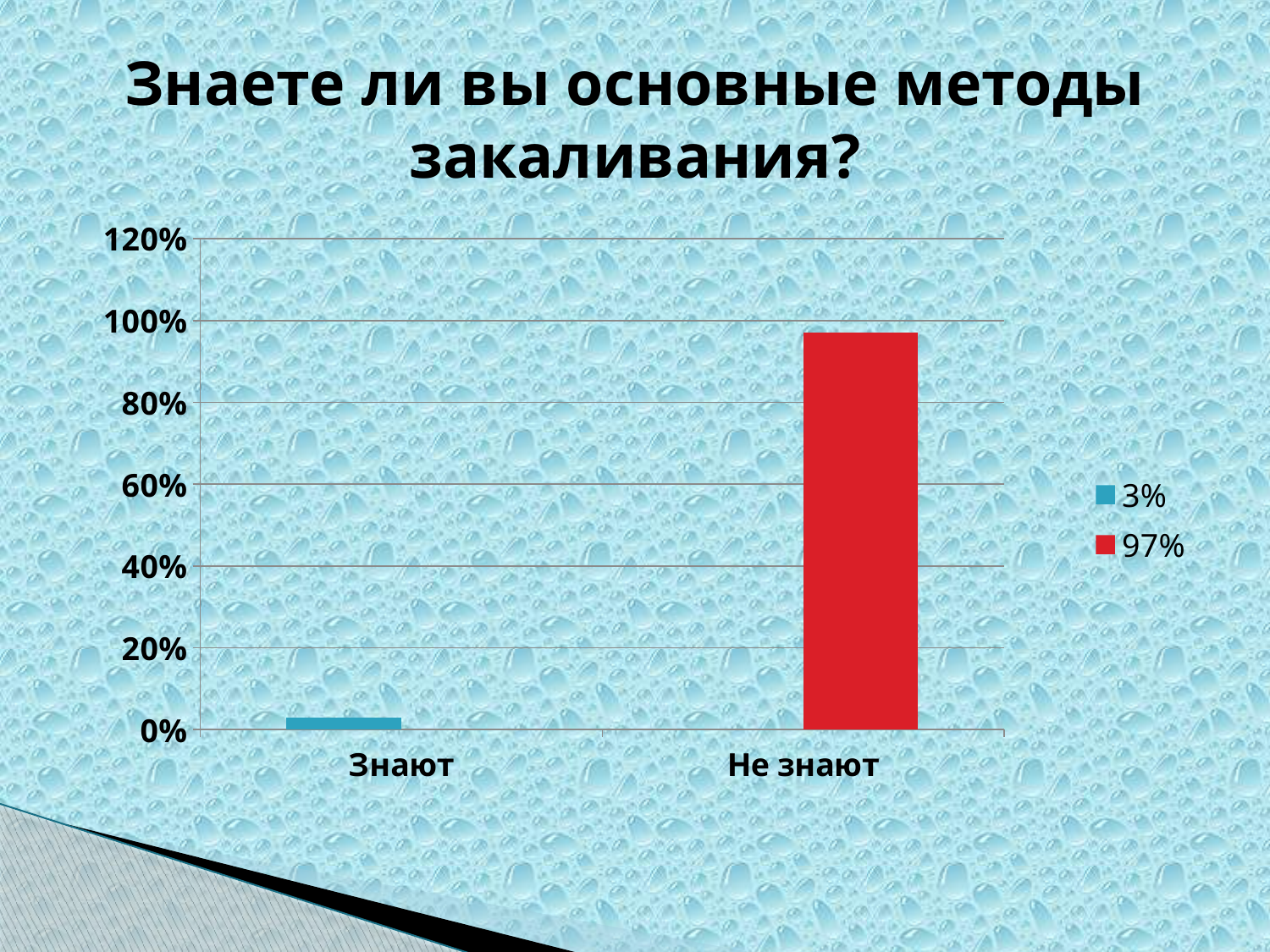
Is the value for Не знают greater or less than 60%? greater What kind of chart is shown on the slide? bar chart How many entries does the chart's legend list? 2 Which category has the lowest bar? Знают How many categories are shown on the x axis of the chart? 2 Which category has the highest bar? Не знают What is the title of the slide above the chart? Знаете ли вы основные методы закаливания? Which bar is taller, Знают or Не знают? Не знают Is the value for Знают greater or less than 20%? less Is the value for Не знают greater or less than 80%? greater Which legend entry is shown with the red colour? 97%